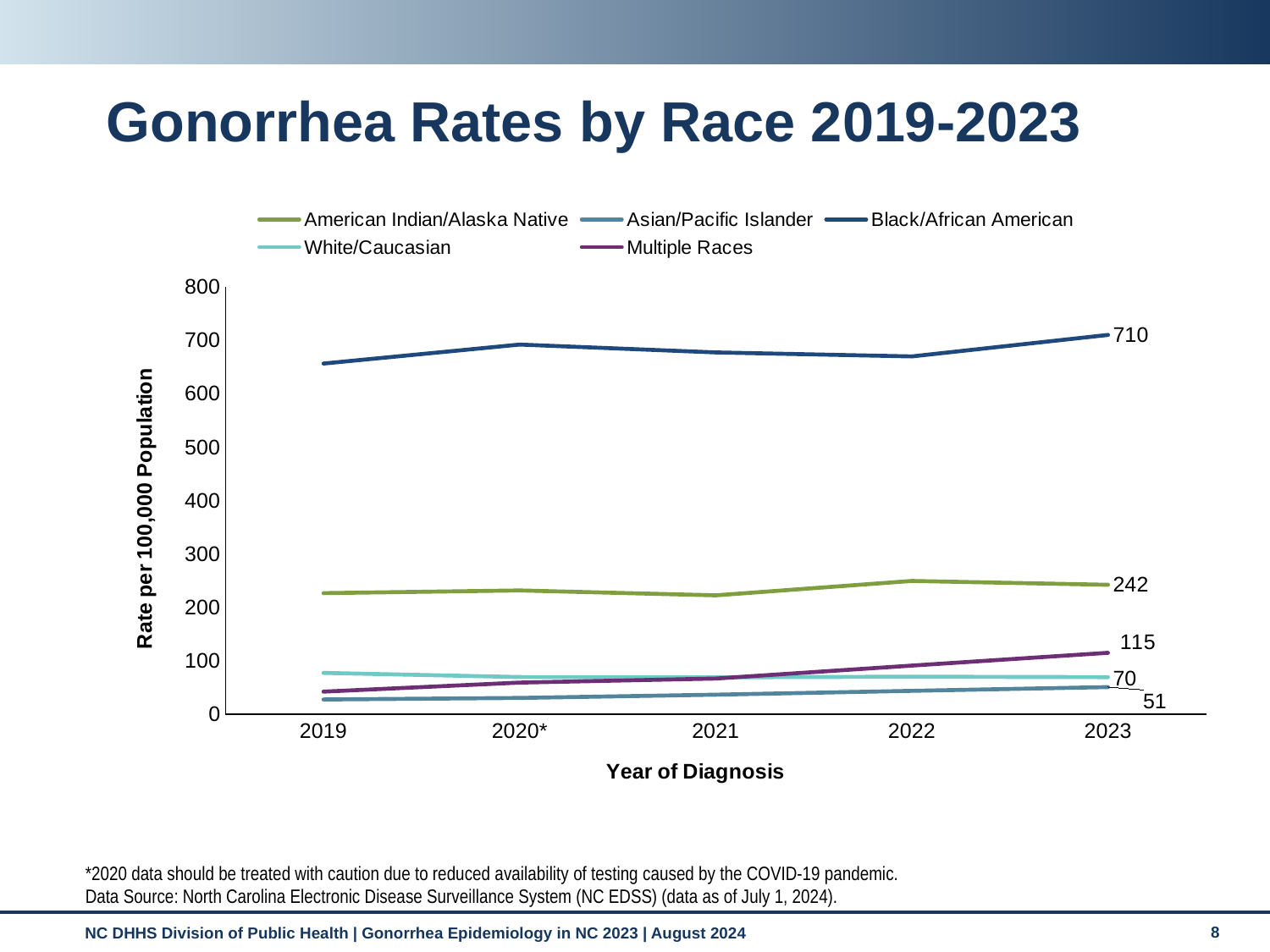
What is the 2023 gonorrhea rate for Asian/Pacific Islander? 51 Which race group has the lowest gonorrhea rate in 2023? Asian/Pacific Islander How many series does the legend list? 5 What is the 2023 gonorrhea rate for American Indian/Alaska Native? 242 What is the 2023 gonorrhea rate for Black/African American? 710 What is the 2023 gonorrhea rate for White/Caucasian? 70 What kind of chart is shown on the slide? Line chart Which race group has the highest gonorrhea rate in 2023? Black/African American Is the 2019 rate for Black/African American greater or less than 600? greater What is the 2023 gonorrhea rate for Multiple Races? 115 What is the difference between the 2023 rates for Black/African American and American Indian/Alaska Native? 468 Does the Multiple Races line rise or fall from 2019 to 2023? Rises